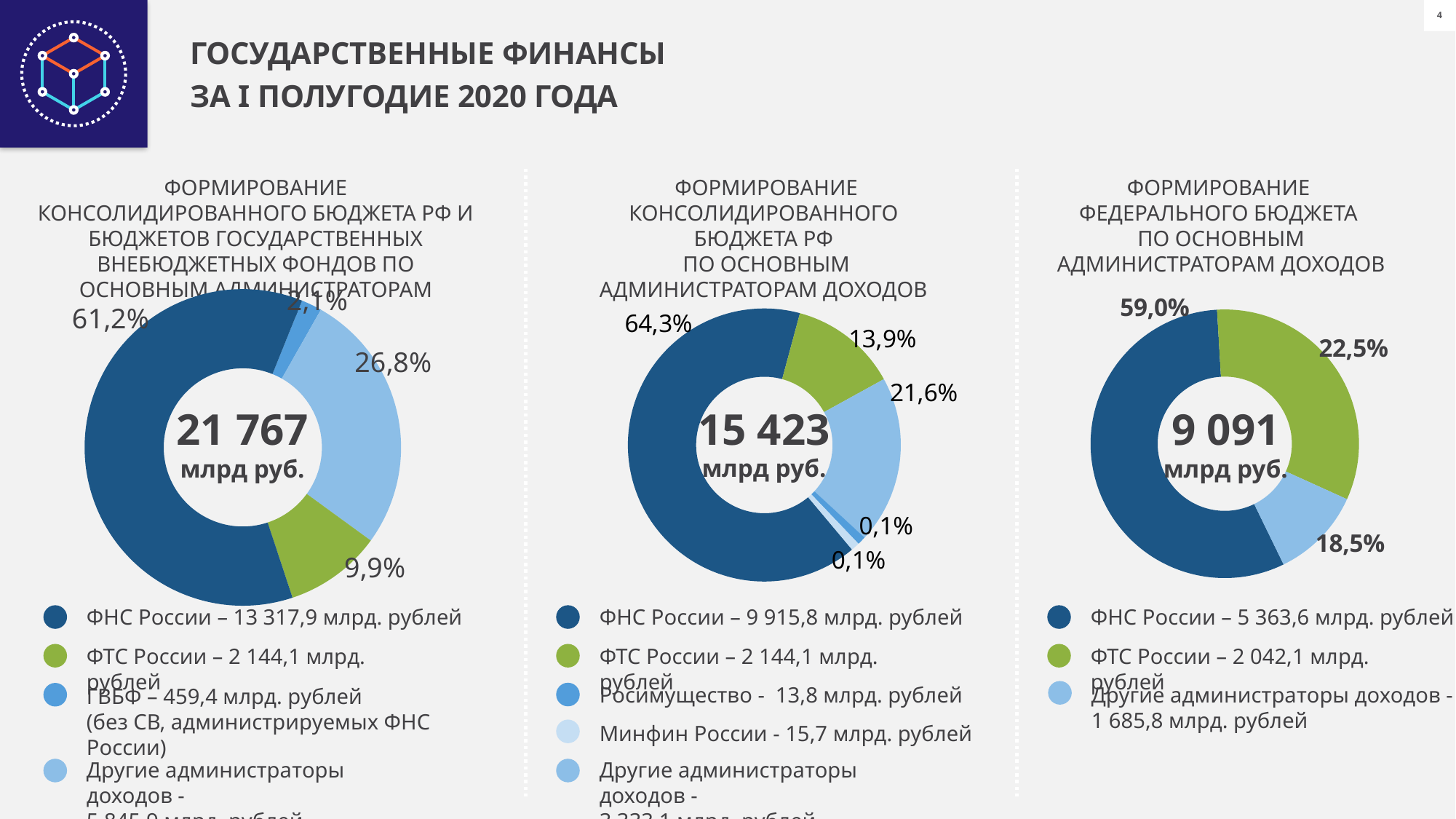
What type of chart is used on this slide? Pie (donut) chart In the right chart, which is larger: the share of ФТС России or the share of Другие администраторы доходов? ФТС России How many categories does the legend of the middle chart list? 5 In the left chart, what is the total value shown in the centre of the donut? 21 767 млрд руб. In the middle chart, what is the difference in percentage points between the ФНС России share and the Другие администраторы доходов share? 42,7 In the left chart, which category has the smallest share? ГВБФ In the left chart, what share of the total does ФНС России account for? 61,2% What is the total value shown in the centre of the right chart? 9 091 млрд руб. In the middle chart, what is the value for Минфин России according to the legend? 15,7 млрд. рублей In the right chart, what is the value for ФТС России according to the legend? 2 042,1 млрд. рублей In the middle chart, what share is shown for ФТС России? 13,9% In the right chart, which category has the largest share? ФНС России